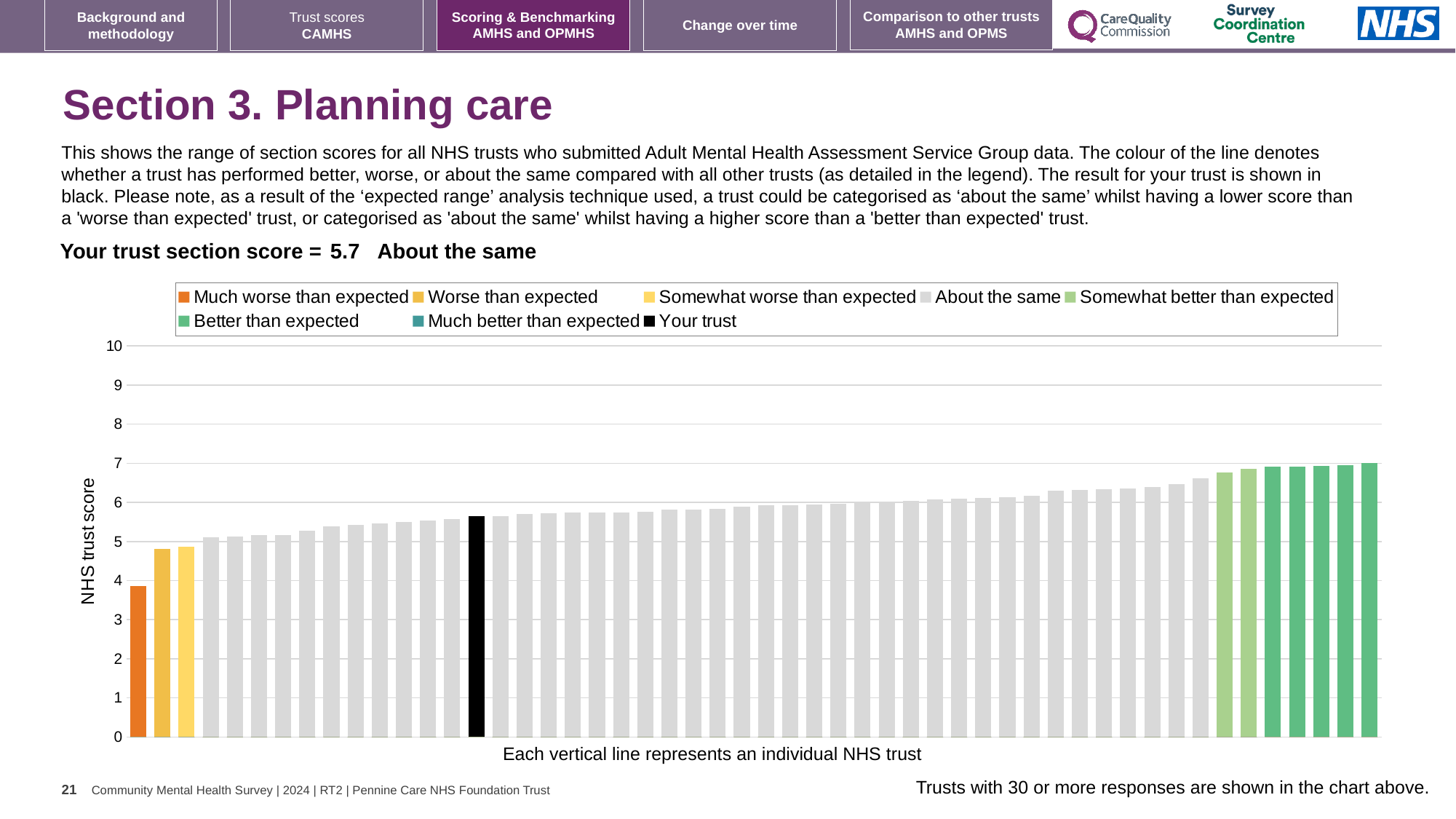
Which legend category does the lowest bar in the chart belong to? Much worse than expected What is the section score for your trust shown on the slide? 5.7 Which legend category do the tallest bars in the chart belong to? Better than expected Which category is your trust placed in for this section? About the same Is the value of the tallest bar in the chart greater or less than 6? greater Is the value of the black 'Your trust' bar greater or less than 5? greater How many entries does the chart legend list? 8 Is the value of the orange 'Much worse than expected' bar greater or less than 5? less What kind of chart is shown on the slide? bar chart Do the bar values rise or fall from left to right along the x axis? rise How many bars are coloured orange for 'Much worse than expected'? 1